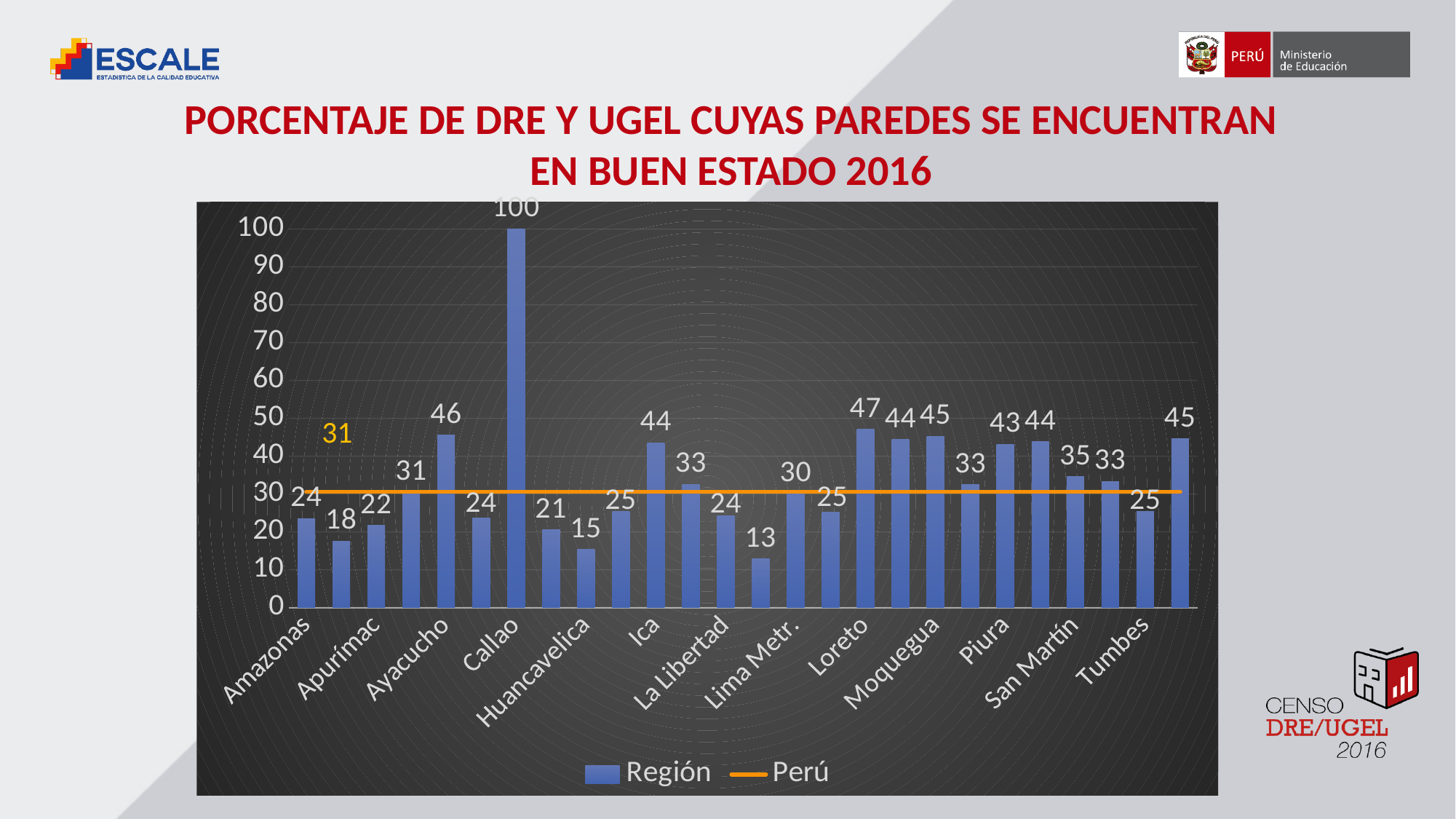
Is the value for Huancavelica greater or less than 20? less Which has a larger value, Loreto or Piura? Loreto How many series does the legend list? 2 What value does the Perú line show? 31 What is the value for Ayacucho? 46 What colour is the Perú line? Orange Which labelled region has the highest value? Callao What is the value for Loreto? 47 What is the value for Huancavelica? 15 What is the value for Callao? 100 How many bars are plotted in the chart? 26 What is the difference between the values for Callao and Ica? 56